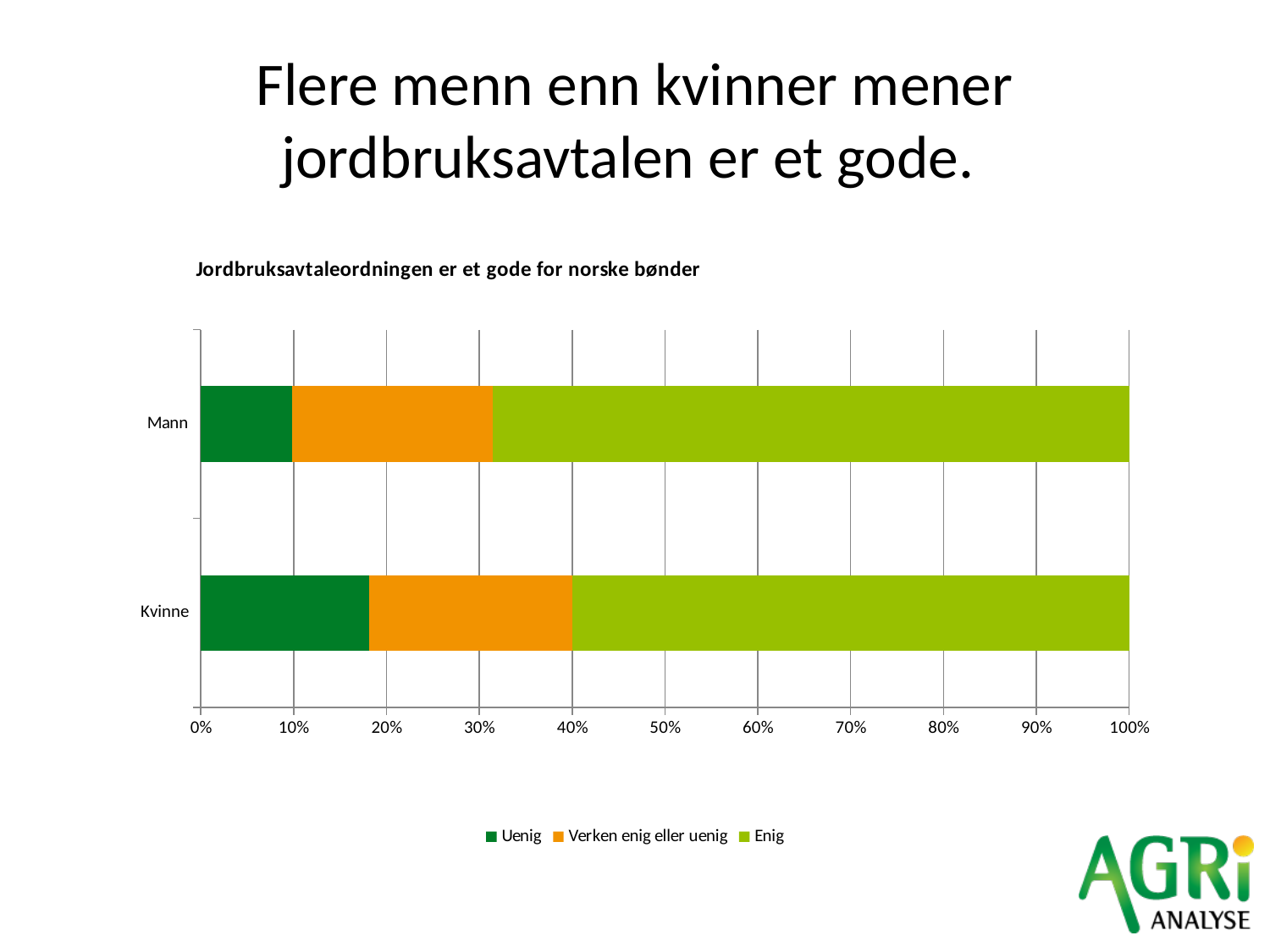
How many series does the chart legend list? 3 Is the Enig share for Mann greater or less than 60%? greater Is the Enig share for Kvinne greater or less than 50%? greater Which series is shown in orange in the chart? Verken enig eller uenig Is the Uenig share for Kvinne greater or less than 10%? greater Which category has the larger Enig share, Mann or Kvinne? Mann How many categories are shown on the vertical axis of the chart? 2 What kind of chart is shown on the slide? Stacked bar chart What is the title of the chart? Jordbruksavtaleordningen er et gode for norske bønder What value does each stacked bar total on the horizontal axis? 100% Which category has the larger Uenig share, Mann or Kvinne? Kvinne